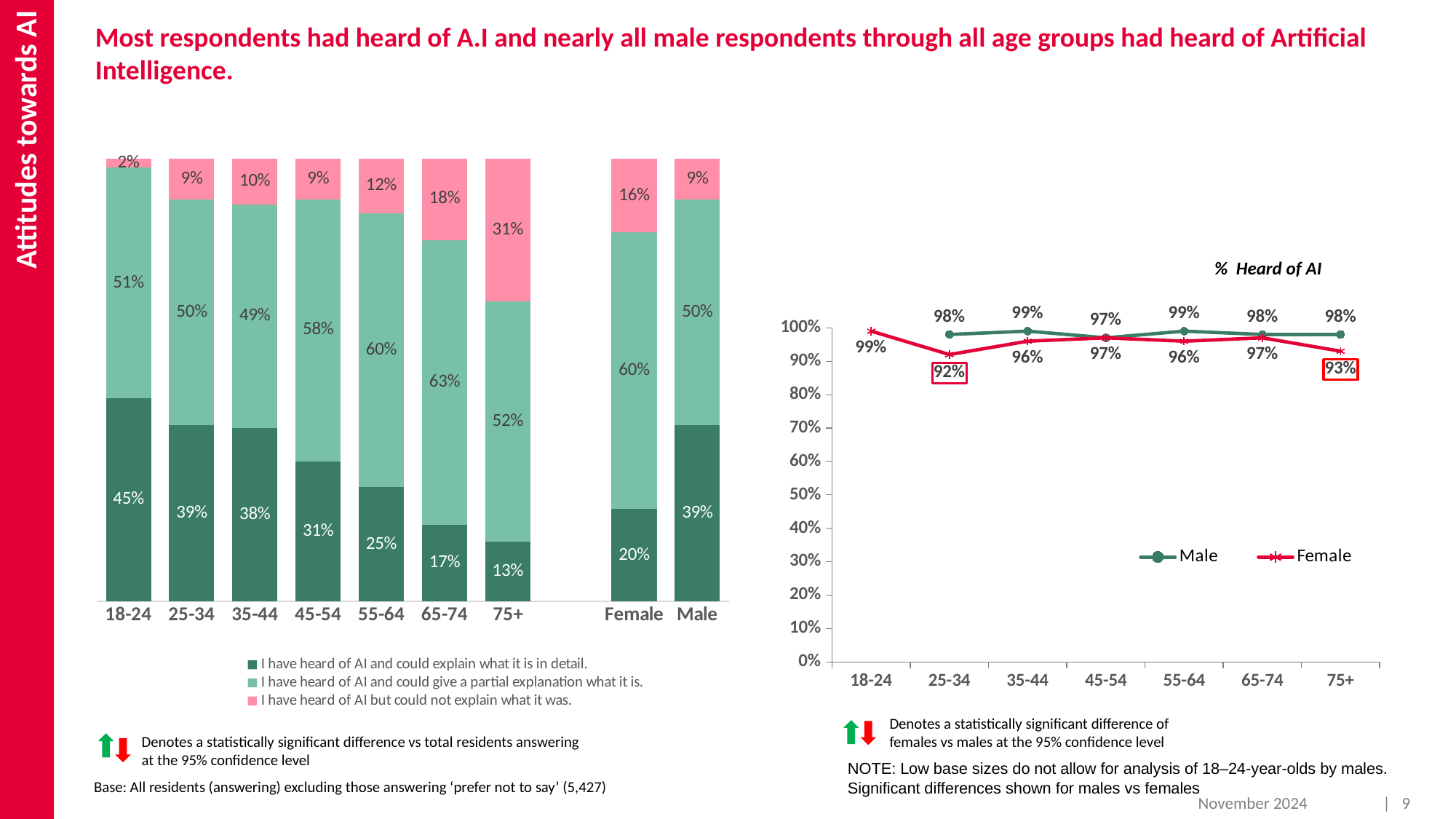
In the stacked bar chart on the left, what percentage of respondents aged 75+ said they have heard of AI but could not explain what it was? 31% In the stacked bar chart on the left, what percentage of 18-24 year olds said they have heard of AI and could explain what it is in detail? 45% What type of chart is the chart on the left of the slide? Stacked bar chart In the '% Heard of AI' chart, which is higher for the 75+ age group, Male or Female? Male How many series does the legend of the stacked bar chart on the left list? 3 In the stacked bar chart on the left, which age group has the highest share of respondents who have heard of AI but could not explain what it was? 75+ In the '% Heard of AI' chart, what is the Male value for the 35-44 age group? 99% In the stacked bar chart on the left, how many percentage points higher is the 'could explain what it is in detail' share for Male than for Female? 19 percentage points In the '% Heard of AI' chart, what is the Female value for the 25-34 age group? 92% In the stacked bar chart on the left, how does the share of respondents who could explain AI in detail change as the age groups go from 18-24 to 75+? It falls In the stacked bar chart on the left, which age group has the lowest share of respondents who could explain AI in detail? 75+ What type of chart is the '% Heard of AI' chart on the right? Line chart